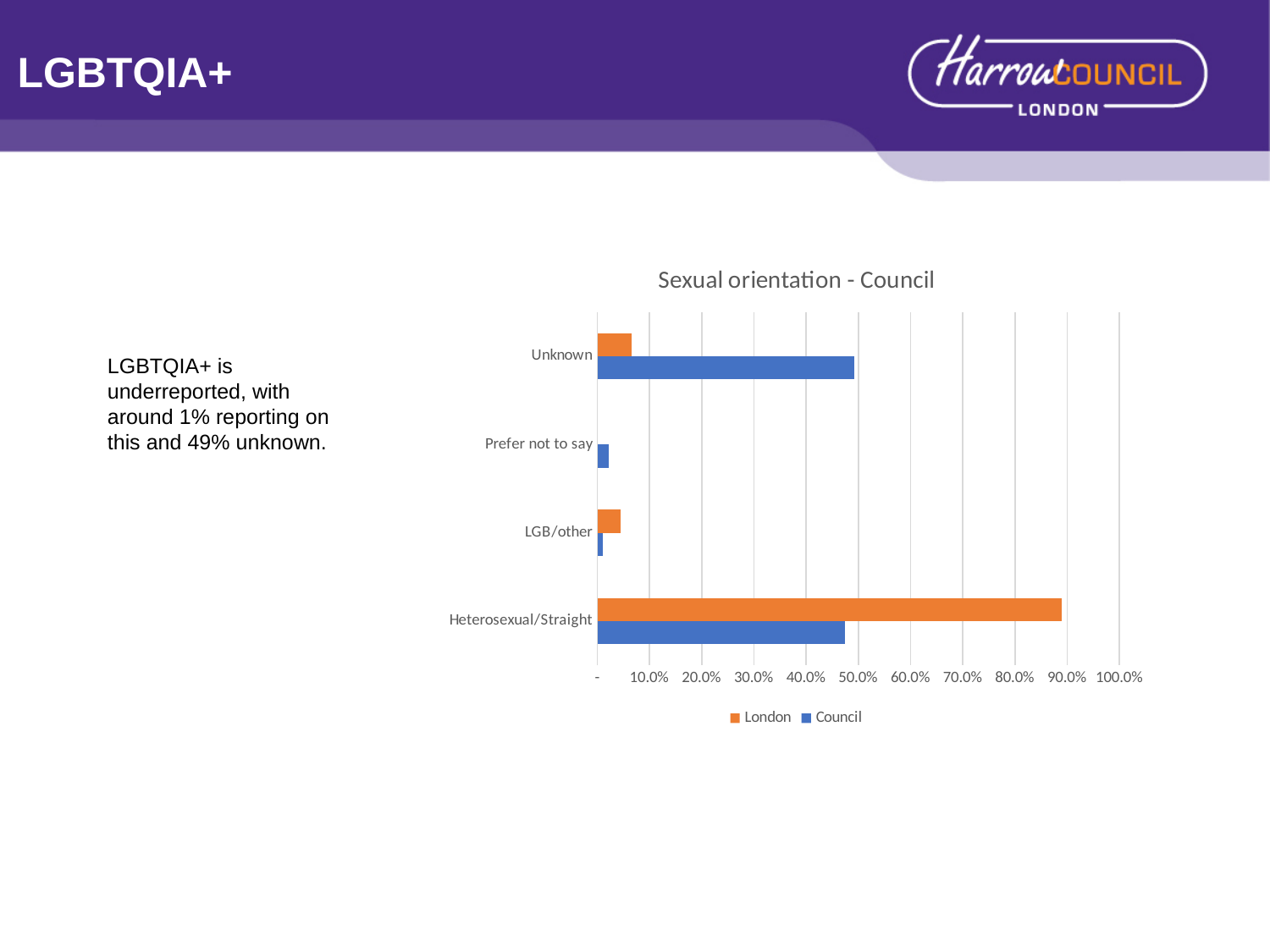
How many categories are shown on the chart's vertical axis? 4 How many series does the chart legend list? 2 For Unknown, which series has the larger value, London or Council? Council Which colour represents the Council series in the chart? Blue Is the Council value for Unknown greater or less than 40.0%? greater What type of chart is shown on the slide? Bar chart Is the London value for Heterosexual/Straight greater or less than 80.0%? greater For LGB/other, which series has the larger value, London or Council? London For Heterosexual/Straight, which series has the larger value, London or Council? London Which category has the highest value for the London series? Heterosexual/Straight What is the title of the chart? Sexual orientation - Council Is the Council value for Heterosexual/Straight greater or less than 60.0%? less